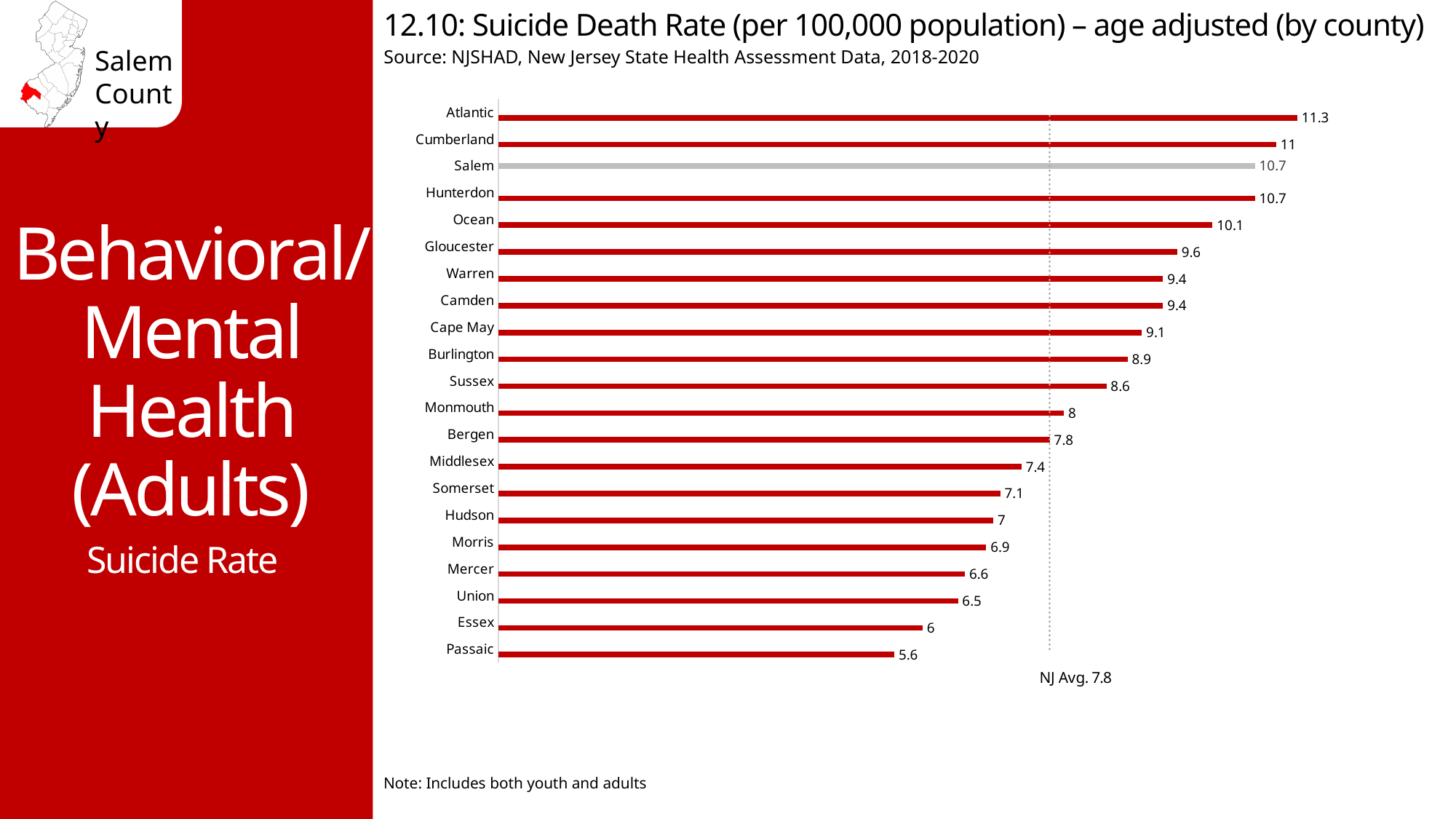
What is the suicide death rate for Gloucester County? 9.6 What is the difference between Salem County's suicide death rate and the NJ average? 2.9 What is the NJ average suicide death rate shown on the chart? 7.8 Which county has the lowest suicide death rate? Passaic What is the suicide death rate for Monmouth County? 8 Which county has the highest suicide death rate? Atlantic What is the suicide death rate for Salem County? 10.7 What type of chart is used on this slide? Bar chart Which county's bar is shown in gray instead of red? Salem Which county has a higher suicide death rate, Ocean or Bergen? Ocean What is the difference between the suicide death rates of Atlantic and Passaic counties? 5.7 How many counties are shown in the chart? 21